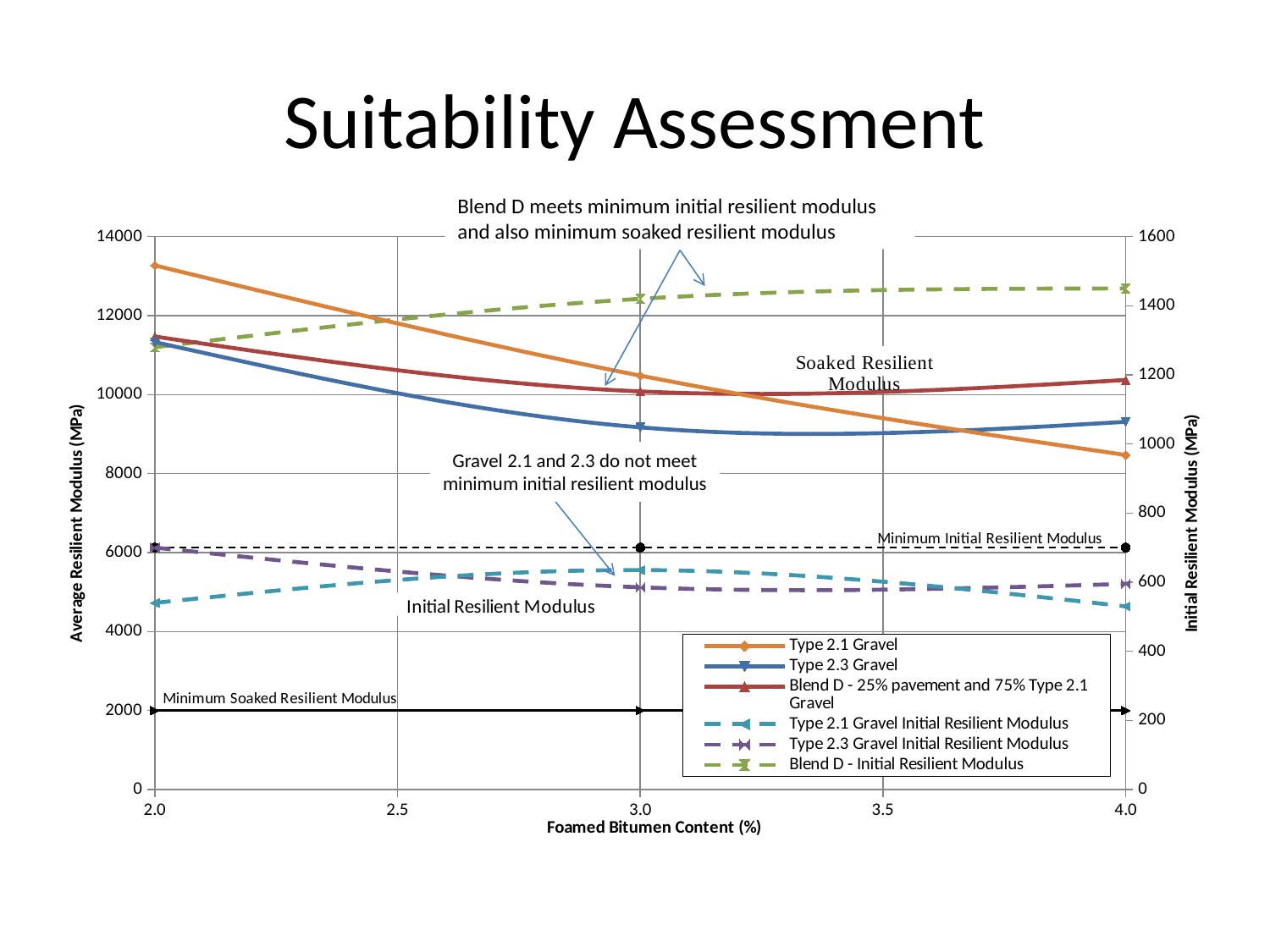
At what value on the left axis does the Minimum Soaked Resilient Modulus line sit? 2000 What is the title of the x axis? Foamed Bitumen Content (%) What kind of chart is shown on the slide? line chart How many foamed bitumen content values are plotted for each series? 3 Does the Type 2.1 Gravel series rise or fall as foamed bitumen content increases from 2.0 to 4.0? fall At 4.0% foamed bitumen content, which is larger: Blend D - 25% pavement and 75% Type 2.1 Gravel or Type 2.3 Gravel? Blend D - 25% pavement and 75% Type 2.1 Gravel How many series does the legend list? 6 Does the Blend D - Initial Resilient Modulus series rise or fall as foamed bitumen content increases from 2.0 to 4.0? rise What is the title of the right-hand y axis? Initial Resilient Modulus (MPa) Which series has the highest value at 2.0% foamed bitumen content? Type 2.1 Gravel Is the value for Type 2.3 Gravel at 4.0% foamed bitumen content greater or less than 10000 on the left axis? less Is the value for Type 2.1 Gravel at 2.0% foamed bitumen content greater or less than 12000 on the left axis? greater